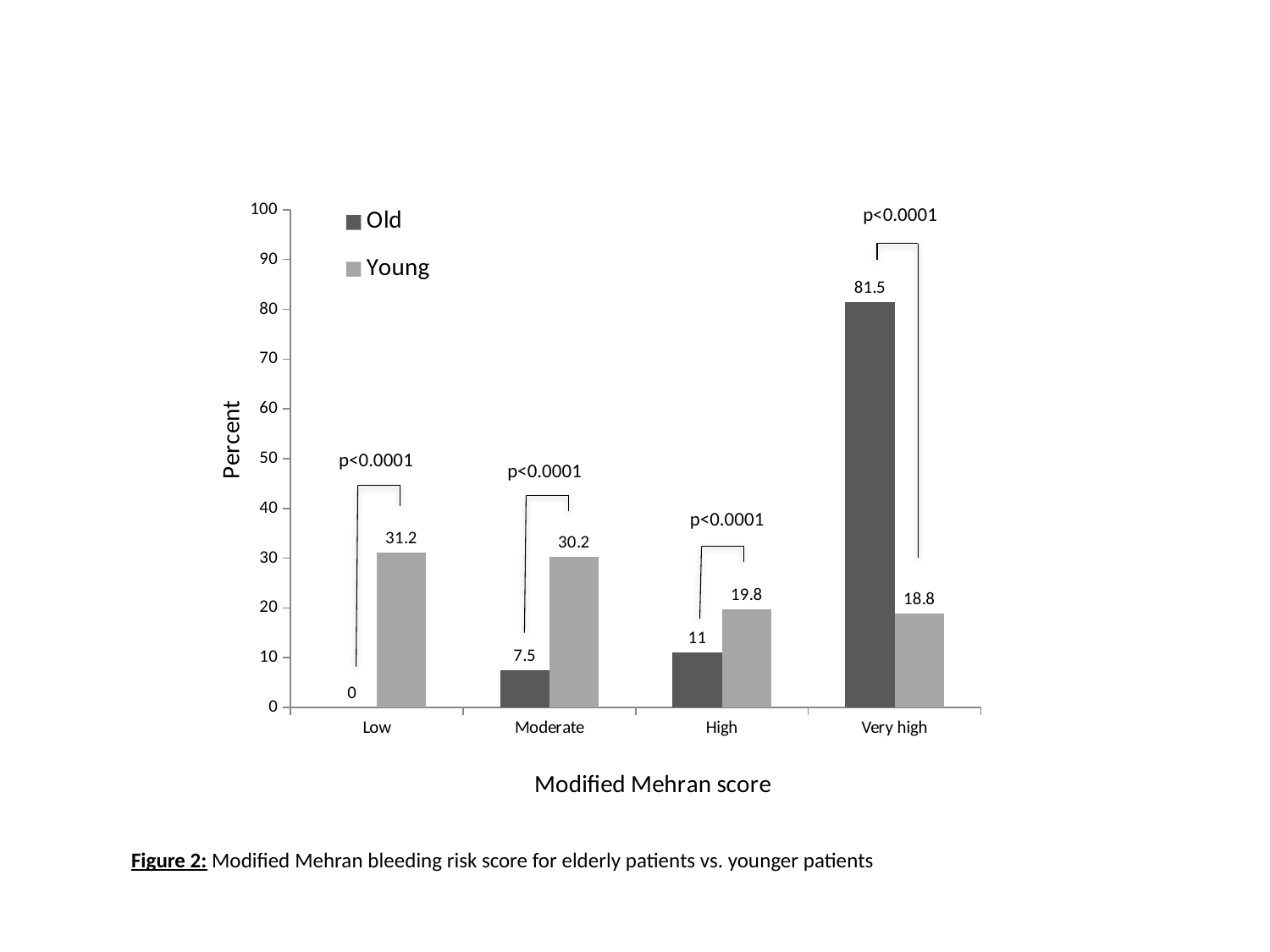
What is the difference between the Old and Young values in the Very high category? 62.7 Which category has the highest value for the Old series? Very high What is the value for Young in the High category? 19.8 In the High category, which series has the larger value, Old or Young? Young What is the label of the x axis? Modified Mehran score Which category has the lowest value for the Young series? Very high How many series does the legend list? 2 What is the value for Old in the Very high category? 81.5 What kind of chart is shown on the slide? Bar chart How many categories are shown on the x axis? 4 What is the value for Old in the Moderate category? 7.5 What is the value for Young in the Low category? 31.2